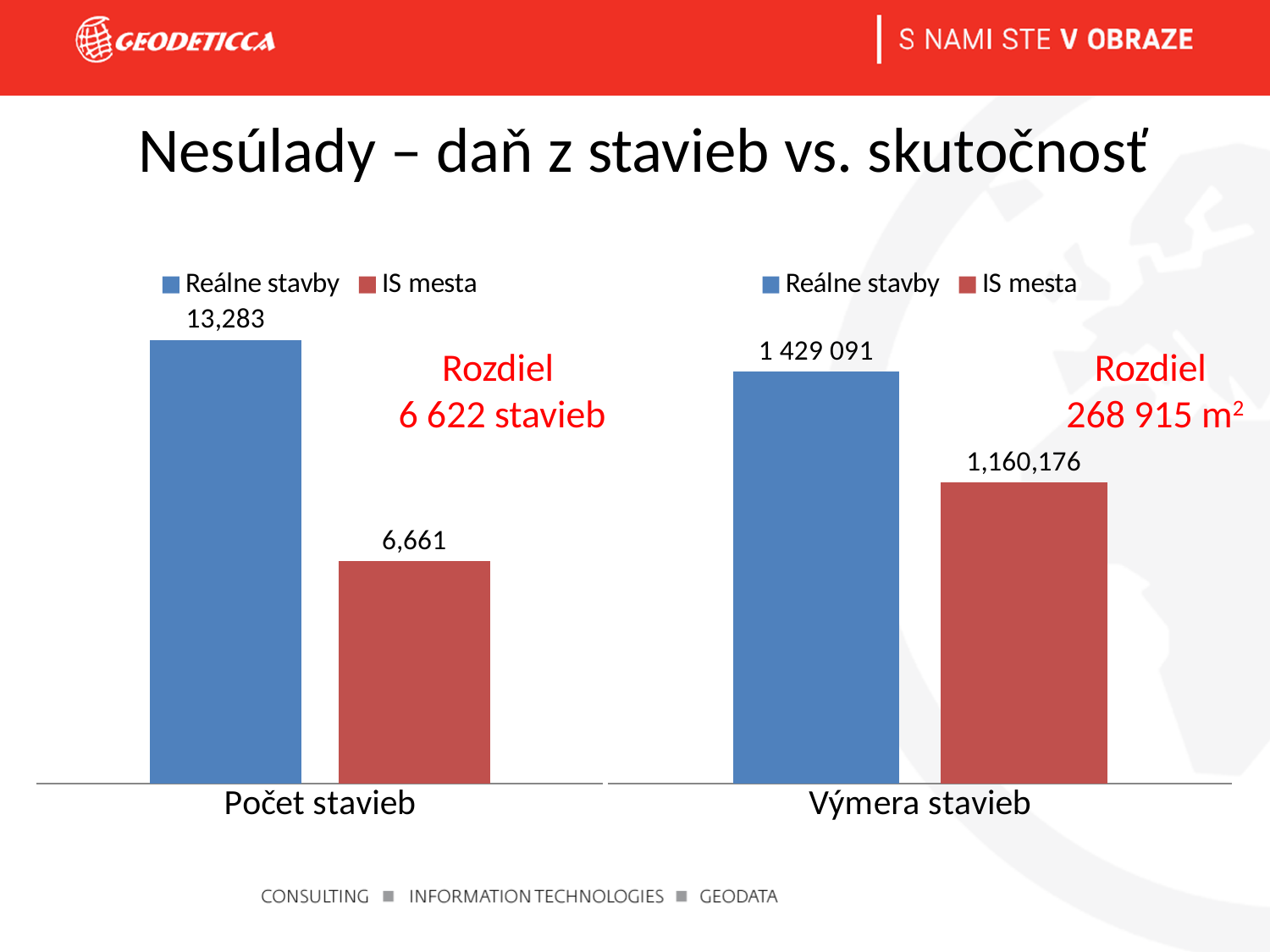
In the right chart (Výmera stavieb), which series has the lower value? IS mesta In the left chart, which colour represents the IS mesta series? red In the left chart (Počet stavieb), what is the difference between Reálne stavby and IS mesta? 6,622 In the left chart (Počet stavieb), what is the value for IS mesta? 6,661 In the right chart (Výmera stavieb), what is the value for Reálne stavby? 1 429 091 In the right chart (Výmera stavieb), what is the value for IS mesta? 1,160,176 What type of chart is the right chart (Výmera stavieb)? bar chart In the right chart (Výmera stavieb), what is the difference between Reálne stavby and IS mesta? 268 915 In the right chart (Výmera stavieb), is the value for Reálne stavby larger or smaller than the value for IS mesta? larger How many series does the legend of the left chart list? 2 In the left chart (Počet stavieb), what is the value for Reálne stavby? 13,283 In the left chart (Počet stavieb), which series has the higher value? Reálne stavby